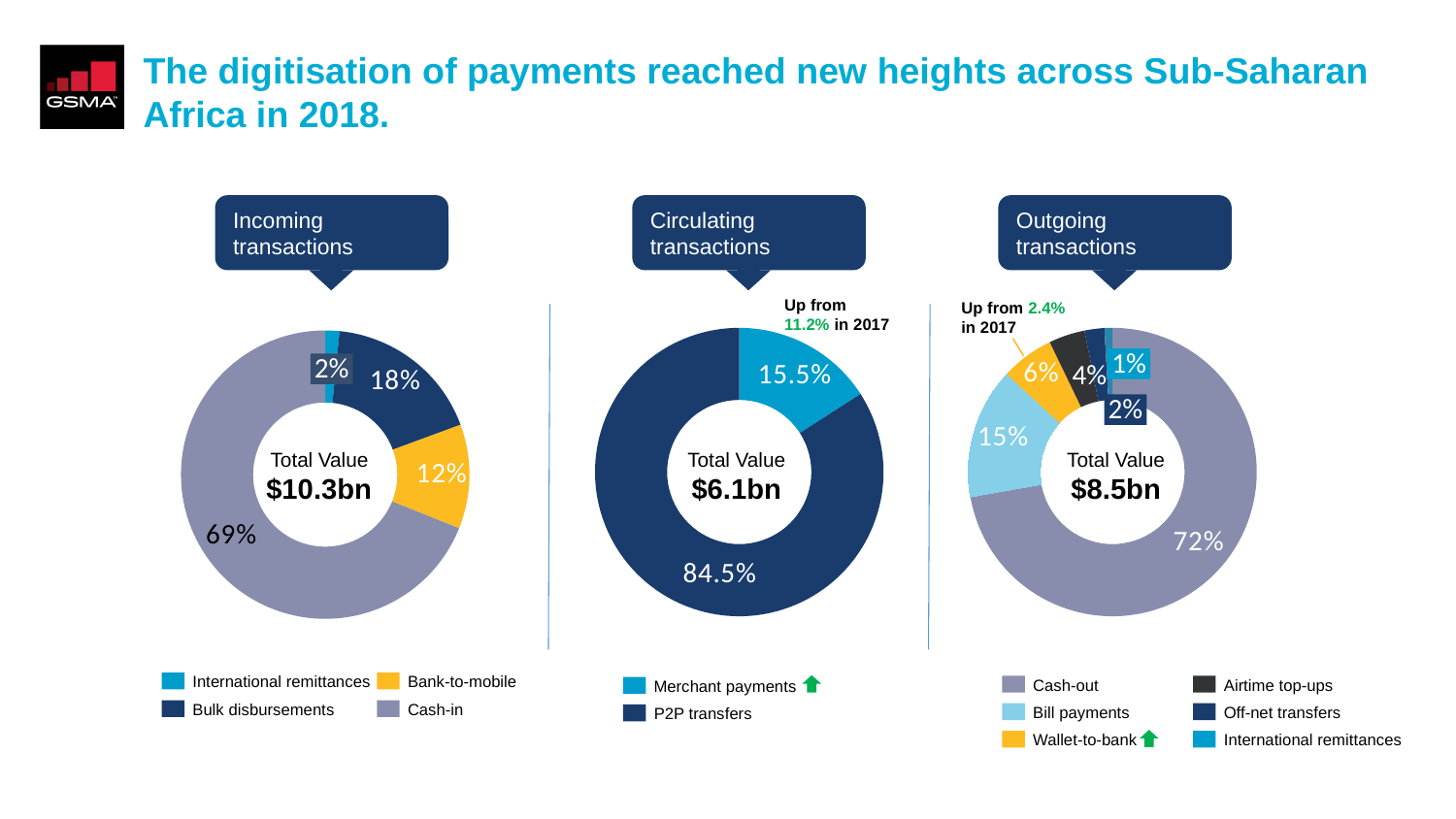
In the Incoming transactions chart, what is the total value shown in the centre? $10.3bn In the Circulating transactions chart, what share is Merchant payments? 15.5% In the Incoming transactions chart, what is the difference between the Bulk disbursements share and the Bank-to-mobile share? 6% In the Incoming transactions chart, which category has the smallest share? International remittances In the Circulating transactions chart, how many categories does the legend list? 2 In the Incoming transactions chart, what share is Cash-in? 69% In the Outgoing transactions chart, what share is Bill payments? 15% What kind of chart is used for the Outgoing transactions? Donut (pie) chart In the Outgoing transactions chart, which is larger, Wallet-to-bank or Airtime top-ups? Wallet-to-bank In the Circulating transactions chart, what share is P2P transfers? 84.5% In the Incoming transactions chart, what share is Bulk disbursements? 18% In the Outgoing transactions chart, what share is Cash-out? 72%